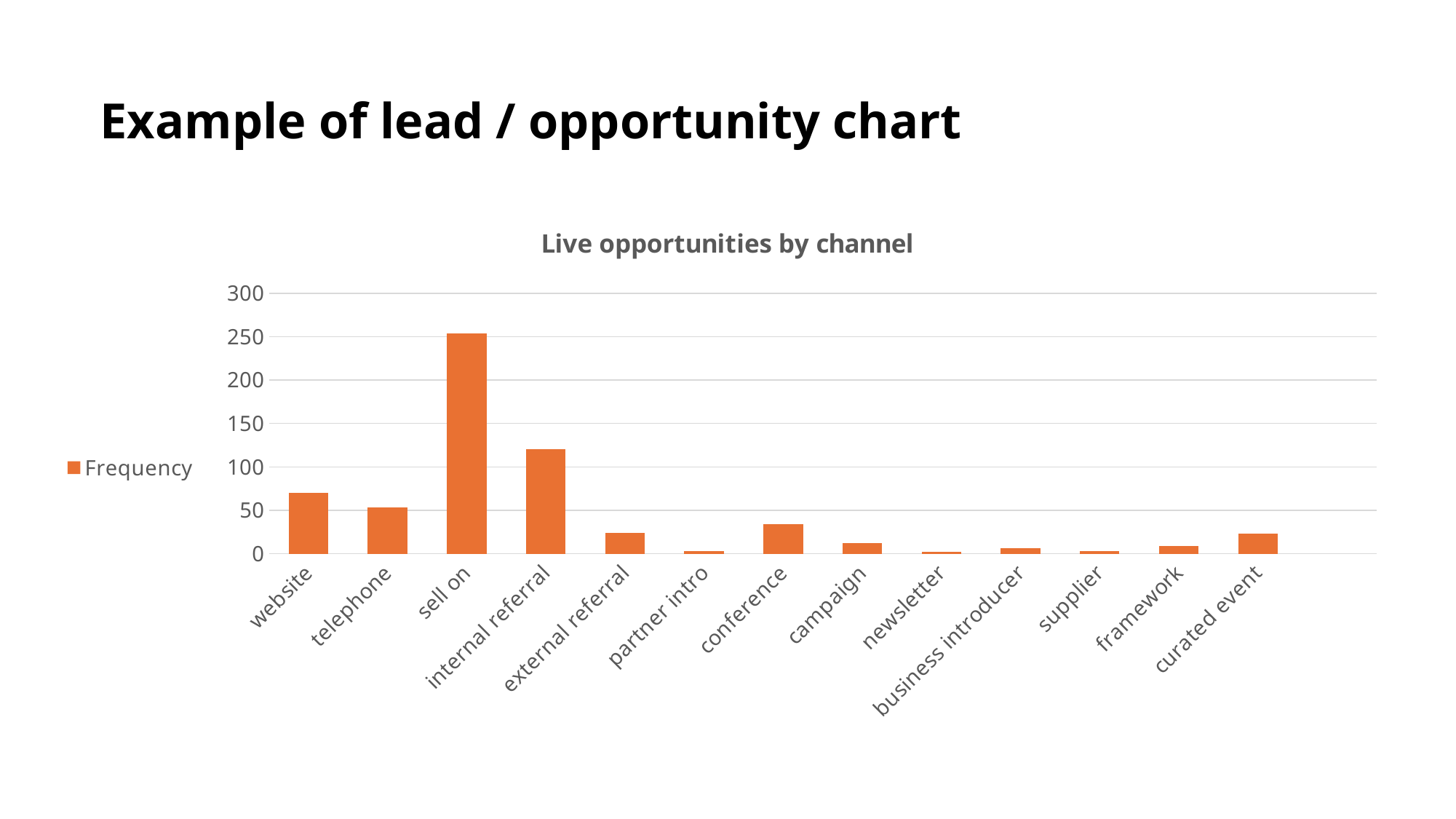
How many channel categories are shown on the x axis? 13 Is the value for sell on greater or less than 200? greater What is the title of the chart? Live opportunities by channel How many series does the legend list? 1 Which has a higher frequency, website or telephone? website Is the value for conference greater or less than 50? less Which channel has the highest frequency? sell on Is the value for website greater or less than 50? greater Which has a higher frequency, conference or campaign? conference What is the name of the series shown in the legend? Frequency What type of chart is shown on the slide? bar chart